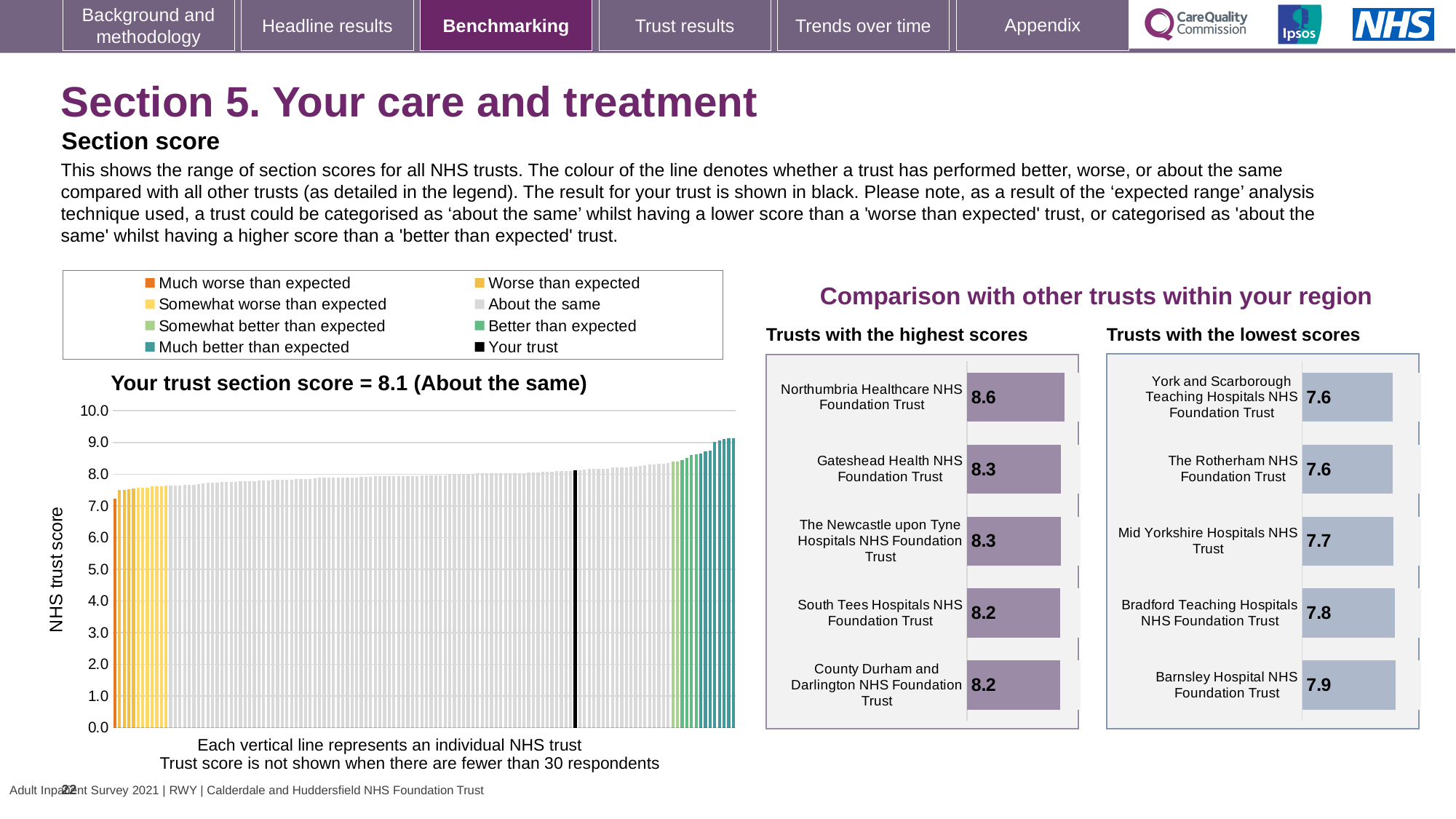
In the 'Trusts with the highest scores' chart, what is the score for Northumbria Healthcare NHS Foundation Trust? 8.6 In the 'Your trust section score' chart, do the trust scores rise or fall from left to right along the x axis? rise In the 'Trusts with the lowest scores' chart, what is the score for Mid Yorkshire Hospitals NHS Trust? 7.7 In the 'Your trust section score' chart, how many entries does the legend list? 8 In the 'Trusts with the highest scores' chart, which trust has the highest score? Northumbria Healthcare NHS Foundation Trust In the 'Trusts with the highest scores' chart, what is the difference between the scores of Northumbria Healthcare NHS Foundation Trust and South Tees Hospitals NHS Foundation Trust? 0.4 In the 'Trusts with the lowest scores' chart, which trust has the highest score? Barnsley Hospital NHS Foundation Trust In the 'Your trust section score' chart, what is the section score for your trust? 8.1 In the 'Trusts with the lowest scores' chart, which has the larger score: Bradford Teaching Hospitals NHS Foundation Trust or The Rotherham NHS Foundation Trust? Bradford Teaching Hospitals NHS Foundation Trust In the 'Your trust section score' chart, what kind of chart is shown? bar chart In the 'Your trust section score' chart, what is the highest value shown on the y axis? 10.0 In the 'Trusts with the highest scores' chart, how many trusts are listed? 5